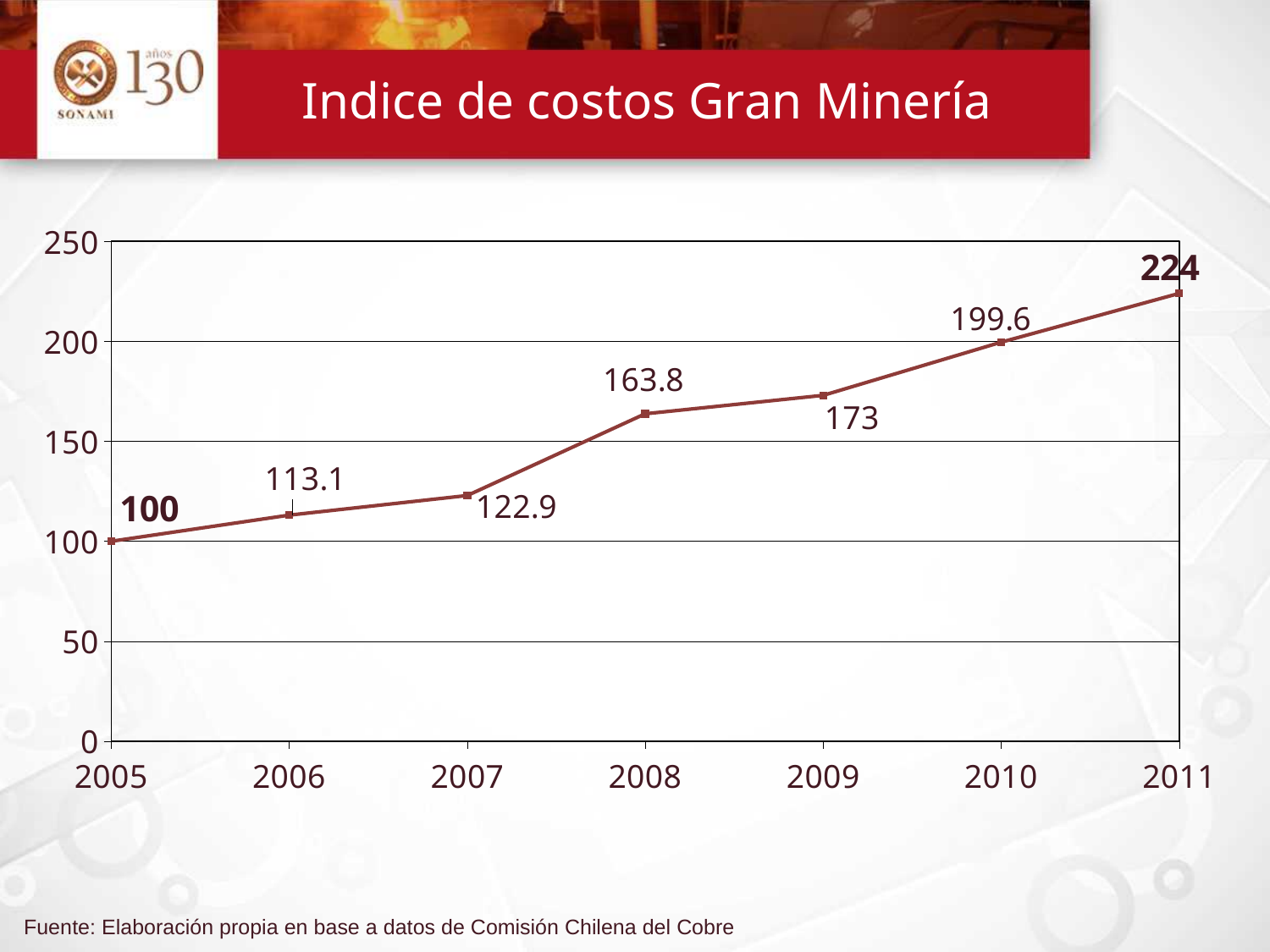
What is the difference between the cost index in 2011 and in 2005? 124 How many years are plotted on the chart? 7 What is the value of the cost index in 2011? 224 Which year has a higher cost index value, 2007 or 2009? 2009 Do the values rise or fall from 2005 to 2011? rise What is the value of the cost index in 2006? 113.1 What is the difference between the cost index in 2010 and in 2009? 26.6 Is the value for 2010 greater or less than 150? greater What is the value of the cost index in 2008? 163.8 What kind of chart is shown on the slide? line chart Which year has the lowest cost index value? 2005 Which year has the highest cost index value? 2011